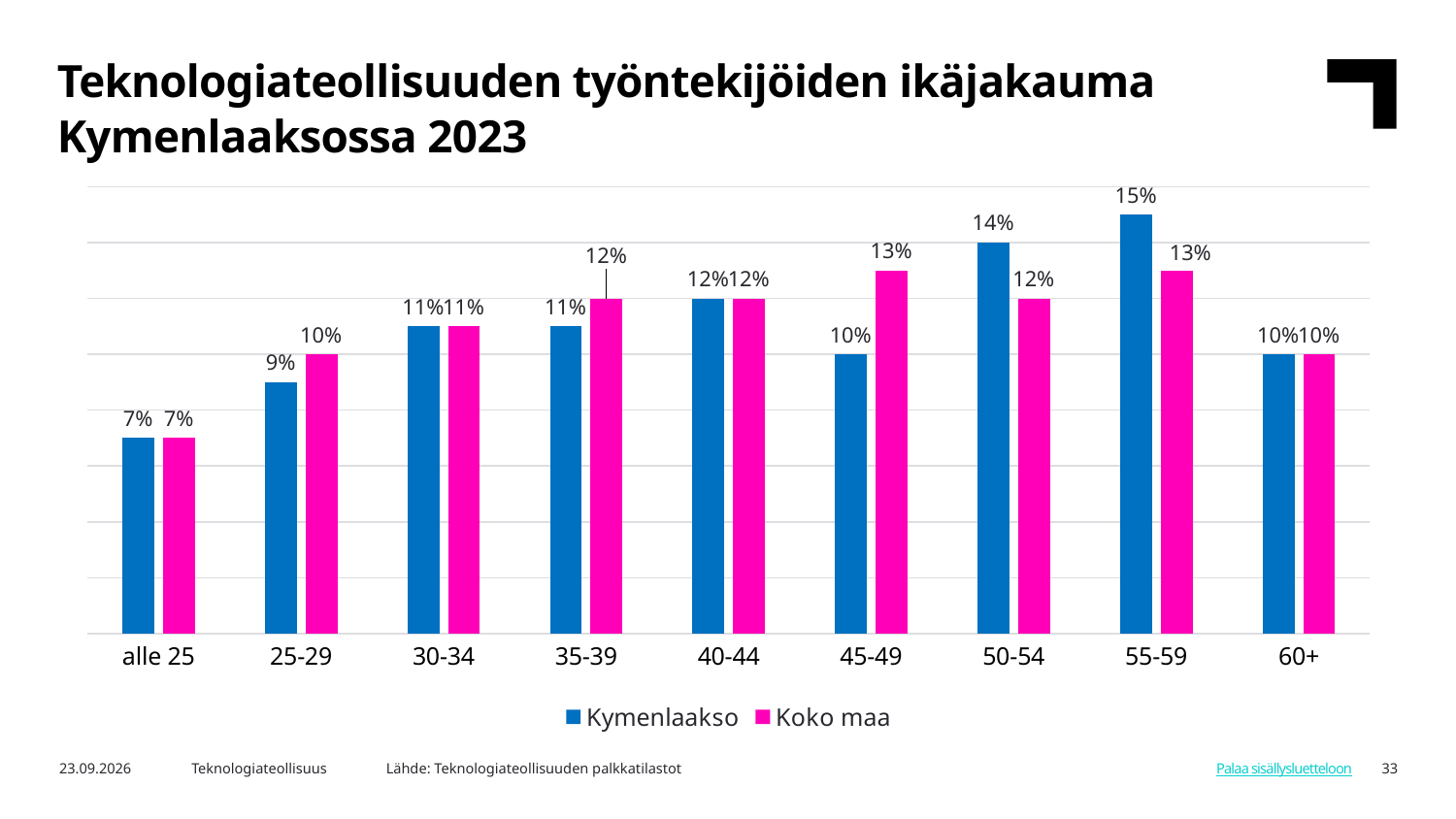
What kind of chart is shown on the slide? Bar chart What is the Koko maa value for the 45-49 age group? 13% What is the Kymenlaakso value for the 25-29 age group? 9% What is the Kymenlaakso value for the 55-59 age group? 15% What is the difference between the Kymenlaakso and Koko maa values for the 45-49 age group? 3% How many series does the legend list? 2 How many age groups are shown on the x axis? 9 Which is larger for the 50-54 age group, Kymenlaakso or Koko maa? Kymenlaakso Which age group has the highest Kymenlaakso value? 55-59 Which is larger for the 35-39 age group, Kymenlaakso or Koko maa? Koko maa Which colour represents the Koko maa series? Pink Which age group has the lowest Koko maa value? alle 25